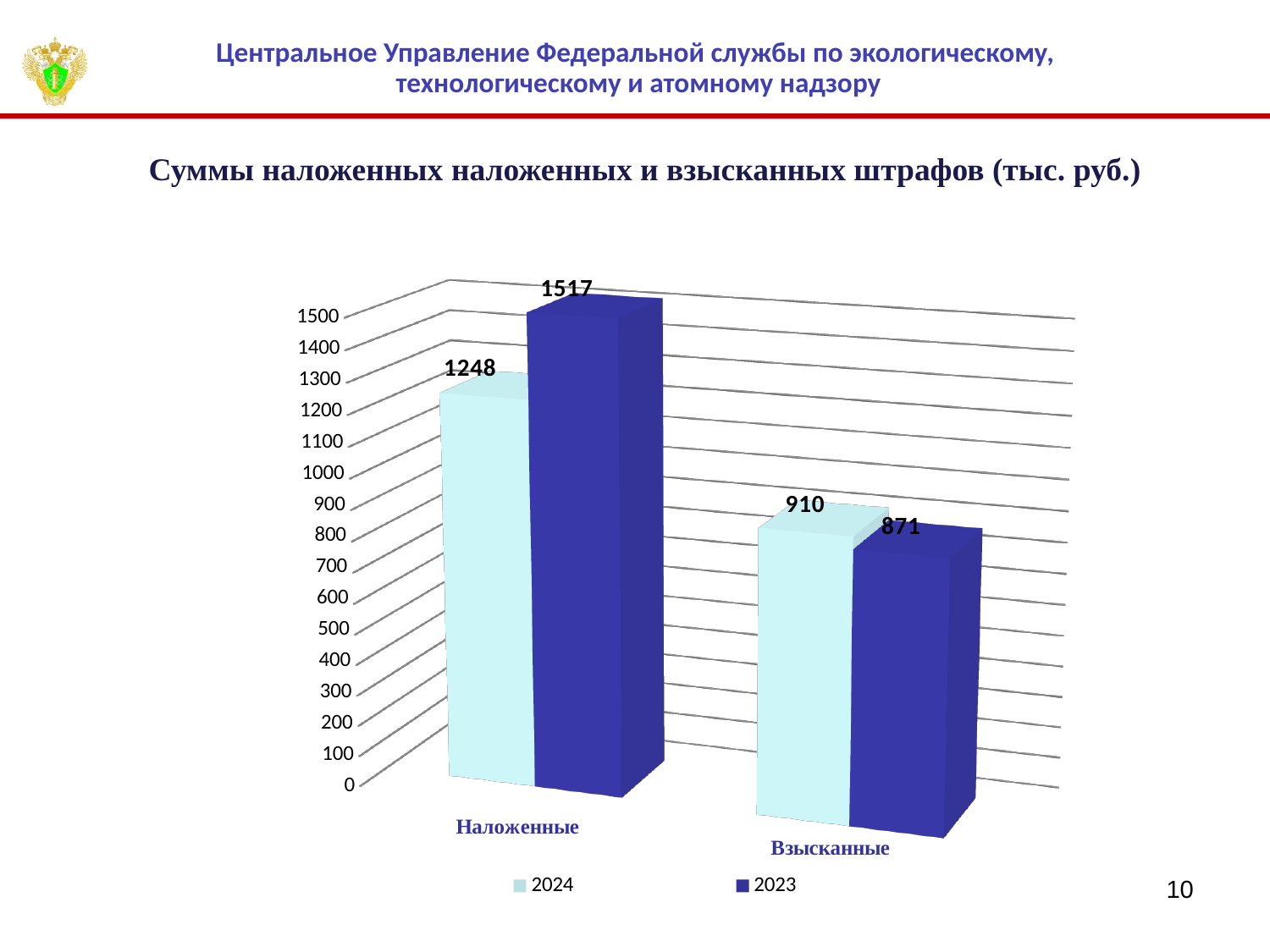
What kind of chart is shown on the slide? Bar chart How many categories are shown on the x axis? 2 What is the value for Наложенные in the 2024 series? 1248 Which category has the highest value in the 2023 series? Наложенные What is the difference between the 2023 and 2024 values for Наложенные? 269 Which is larger for Наложенные: the 2024 value or the 2023 value? 2023 What is the value for Взысканные in the 2023 series? 871 What is the difference between the 2024 and 2023 values for Взысканные? 39 What is the value for Наложенные in the 2023 series? 1517 Which category has the lowest value in the 2024 series? Взысканные How many series does the legend list? 2 What is the value for Взысканные in the 2024 series? 910